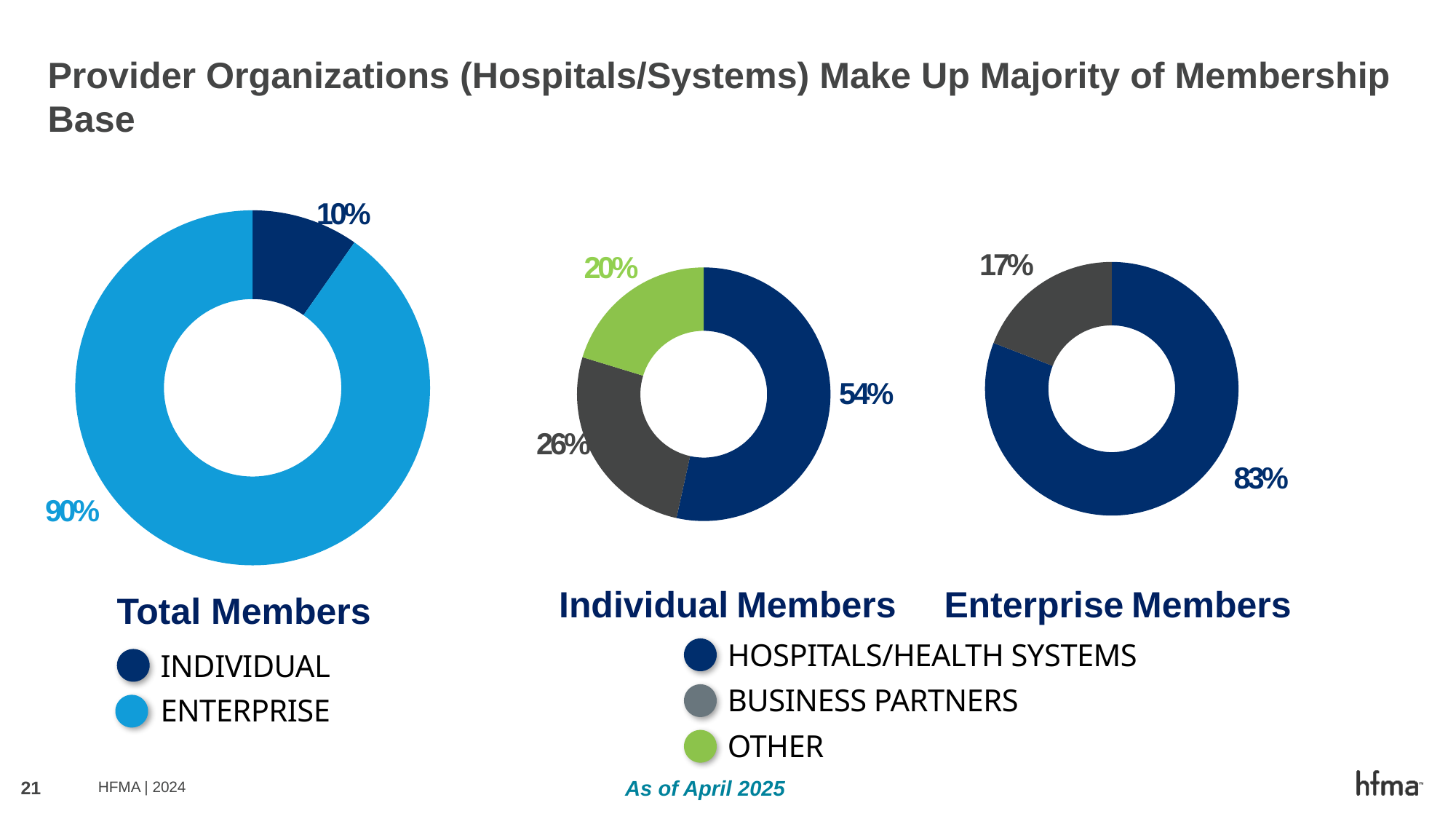
What kind of chart is the Total Members chart? Donut chart How many categories does the Individual Members chart show? 3 In the Enterprise Members chart, what share is Hospitals/Health Systems? 83% In the Individual Members chart, what share is Hospitals/Health Systems? 54% In the Enterprise Members chart, what share is Business Partners? 17% In the Individual Members chart, which category has the smallest share? Other In the Individual Members chart, what is the difference between the Hospitals/Health Systems share and the Business Partners share? 28% In the Individual Members chart, what share is Other? 20% In the Total Members chart, what share of members is Enterprise? 90% Which is larger: the Hospitals/Health Systems share in the Enterprise Members chart or in the Individual Members chart? Enterprise Members In the Individual Members chart, what share is Business Partners? 26% In the Total Members chart, what share of members is Individual? 10%